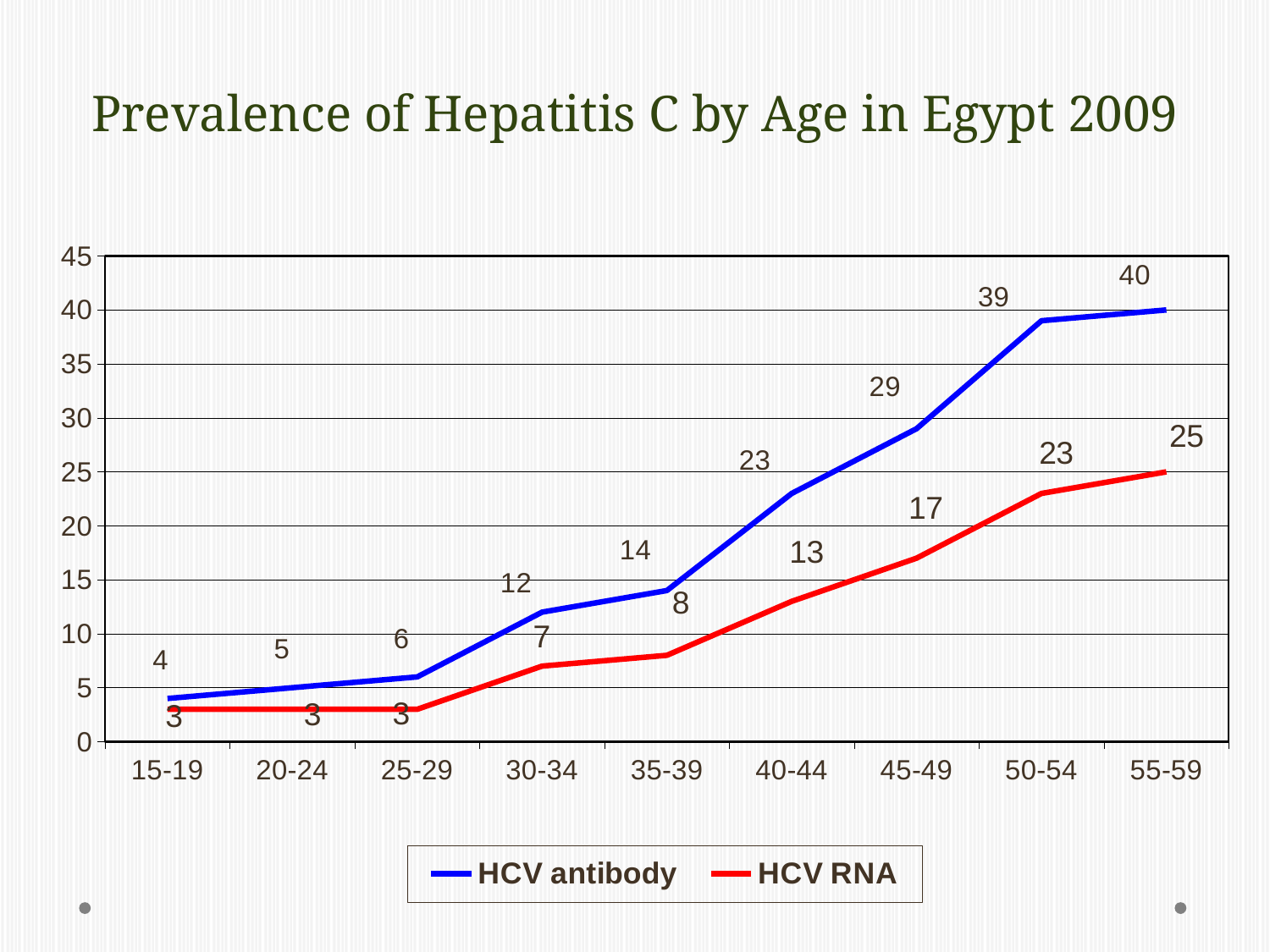
What is the HCV antibody value for the 40-44 age group? 23 Which is larger for the 35-39 age group, HCV antibody or HCV RNA? HCV antibody How many series does the legend list? 2 Is the HCV RNA value for the 55-59 age group greater or less than 20? greater Do the HCV antibody values rise or fall as age increases along the x axis? rise What is the HCV RNA value for the 45-49 age group? 17 What colour is the HCV RNA line? red Which age group has the highest HCV antibody value? 55-59 How many age groups are shown on the x axis? 9 What is the difference between the HCV antibody and HCV RNA values for the 50-54 age group? 16 Which age group has the lowest HCV antibody value? 15-19 What type of chart is shown on the slide? line chart